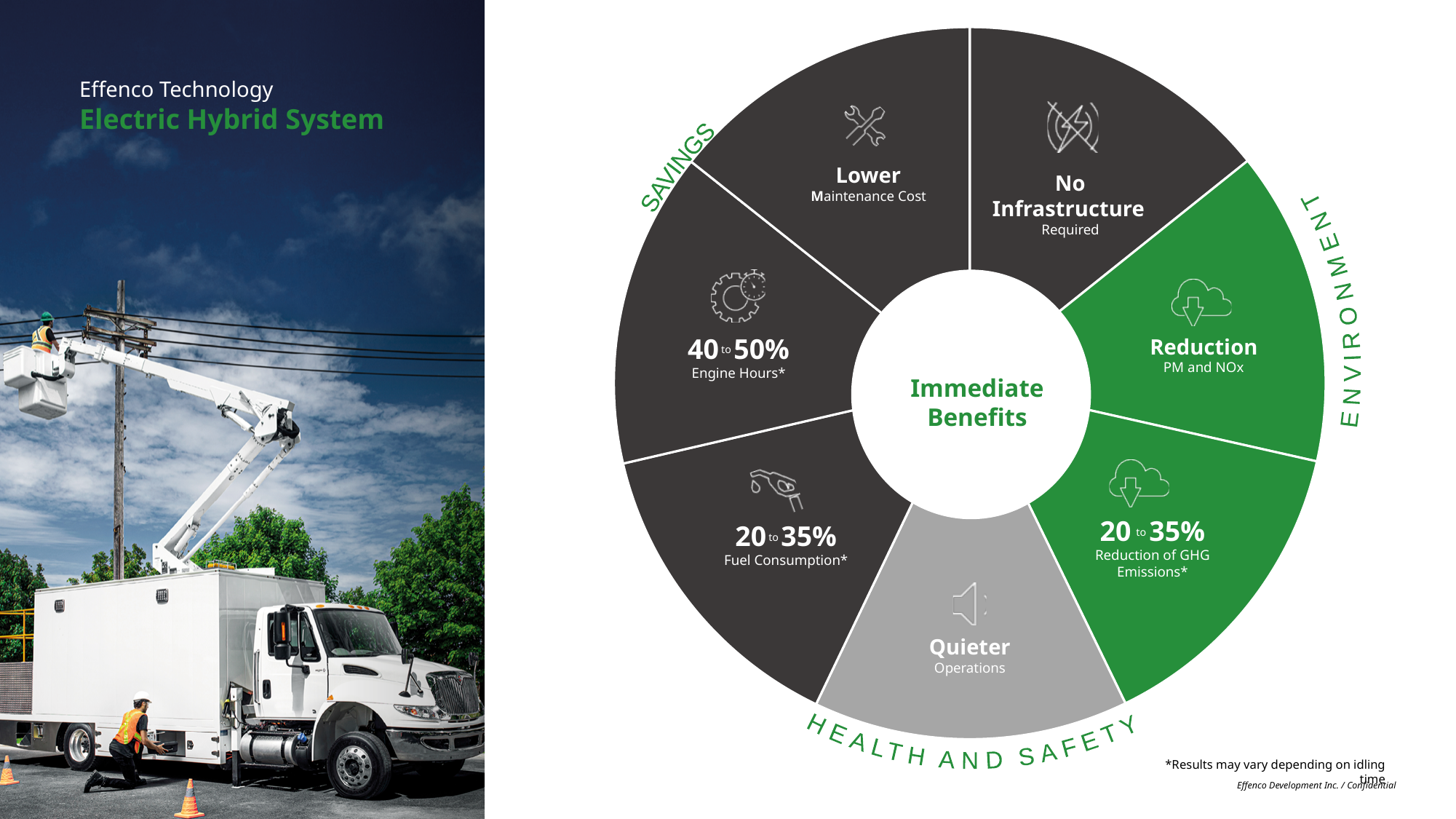
What colour are the Environment segments of the ring diagram? Green What reduction in fuel consumption is printed on the ring diagram? 20 to 35% What reduction in engine hours is printed in the Savings section of the ring? 40 to 50% How many segments belong to the Environment group of the ring? 2 Which benefit segment sits directly to the right of the top centre of the ring, next to Lower Maintenance Cost? No Infrastructure Required What text appears in the centre of the ring diagram? Immediate Benefits What reduction of GHG emissions is printed in the Environment section of the ring? 20 to 35% How many segments make up the ring diagram? 7 How many benefit groups are labelled around the outside of the ring (Savings, Environment, Health and Safety)? 3 Which benefit is shown in the light grey segment at the bottom of the ring? Quieter Operations